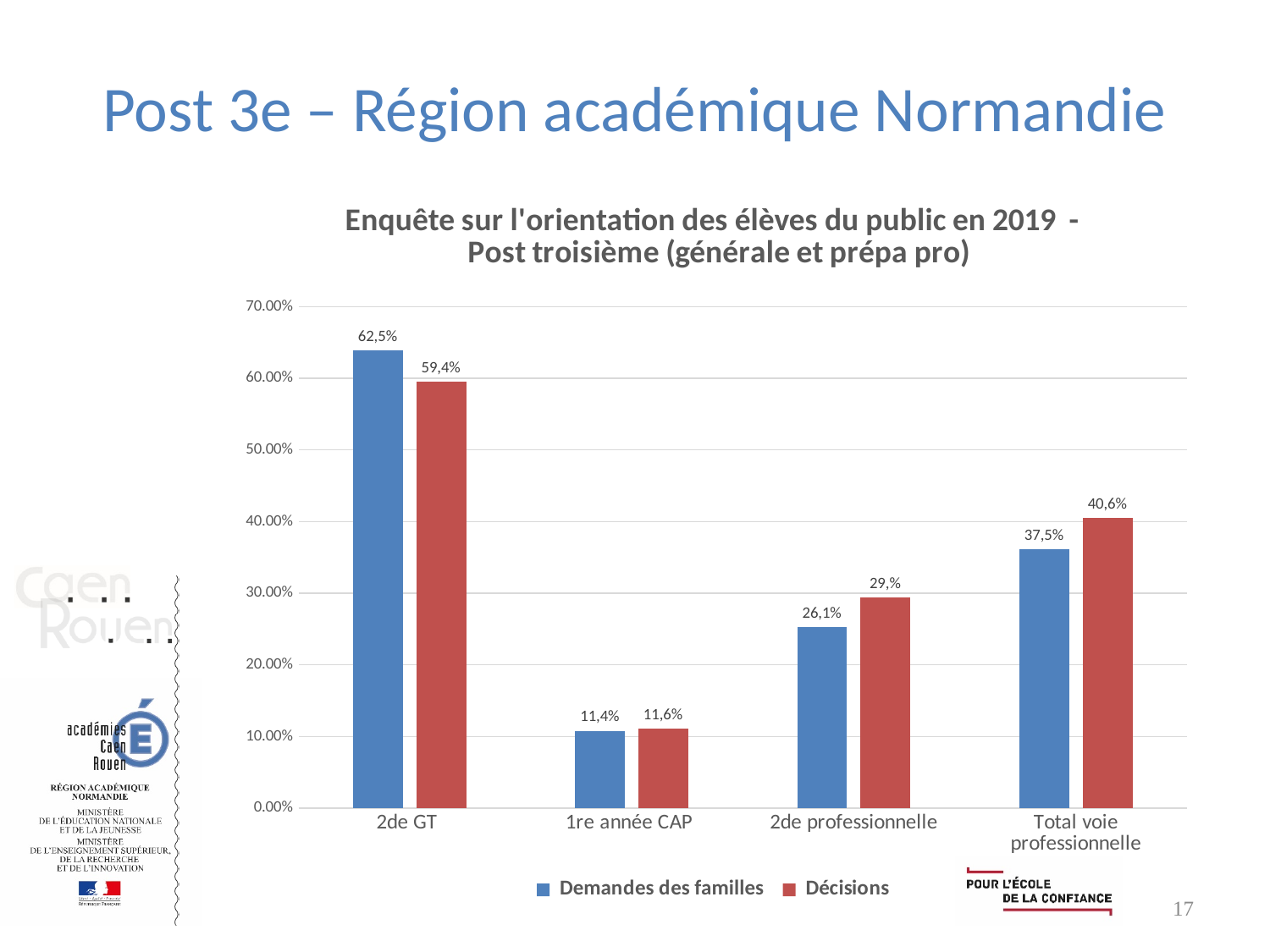
What is the value of Décisions for Total voie professionnelle? 40,6% What is the difference between Demandes des familles and Décisions for 2de GT? 3,1 percentage points Which category has the highest value for Demandes des familles? 2de GT How many series does the legend list? 2 What is the value of Décisions for 2de GT? 59,4% What is the value of Demandes des familles for 2de GT? 62,5% Which category has the lowest value for Décisions? 1re année CAP For 2de professionnelle, which is larger: Demandes des familles or Décisions? Décisions How many categories are shown on the x axis? 4 What is the difference between Décisions and Demandes des familles for Total voie professionnelle? 3,1 percentage points What is the value of Demandes des familles for 2de professionnelle? 26,1% What kind of chart is shown on the slide? Bar chart